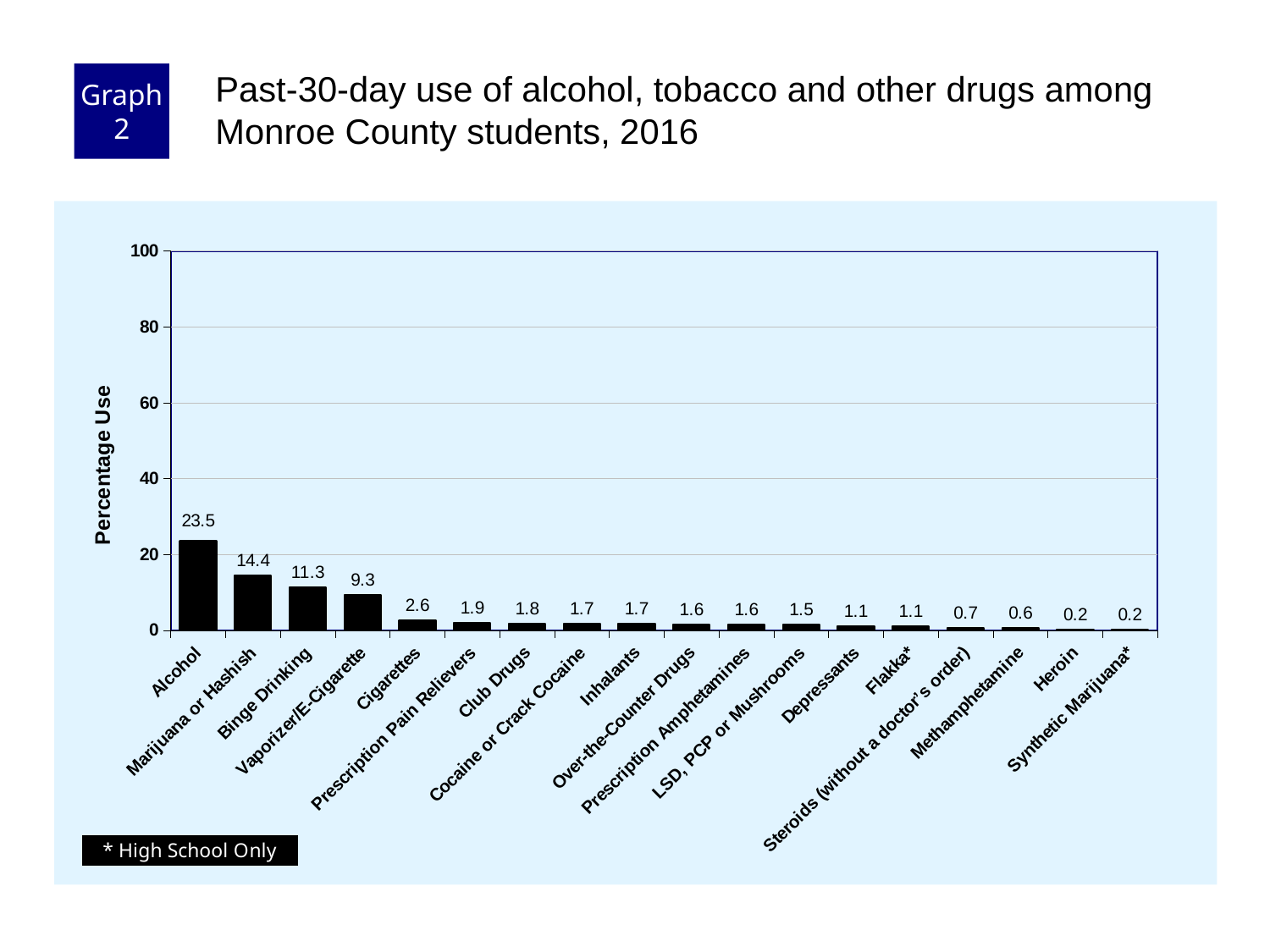
Which category has the highest past-30-day use? Alcohol What is the past-30-day use percentage for Alcohol? 23.5 What is the value shown for Vaporizer/E-Cigarette? 9.3 How many categories are shown on the x axis? 18 What is the value shown for Methamphetamine? 0.6 What is the label of the y axis? Percentage Use What is the difference between the values for Alcohol and Marijuana or Hashish? 9.1 Which is larger, the value for Binge Drinking or the value for Cigarettes? Binge Drinking What kind of chart is shown on the slide? Bar chart What is the value shown for Cigarettes? 2.6 Is the value for Alcohol greater or less than 20? greater What is the difference between the values for Binge Drinking and Vaporizer/E-Cigarette? 2.0